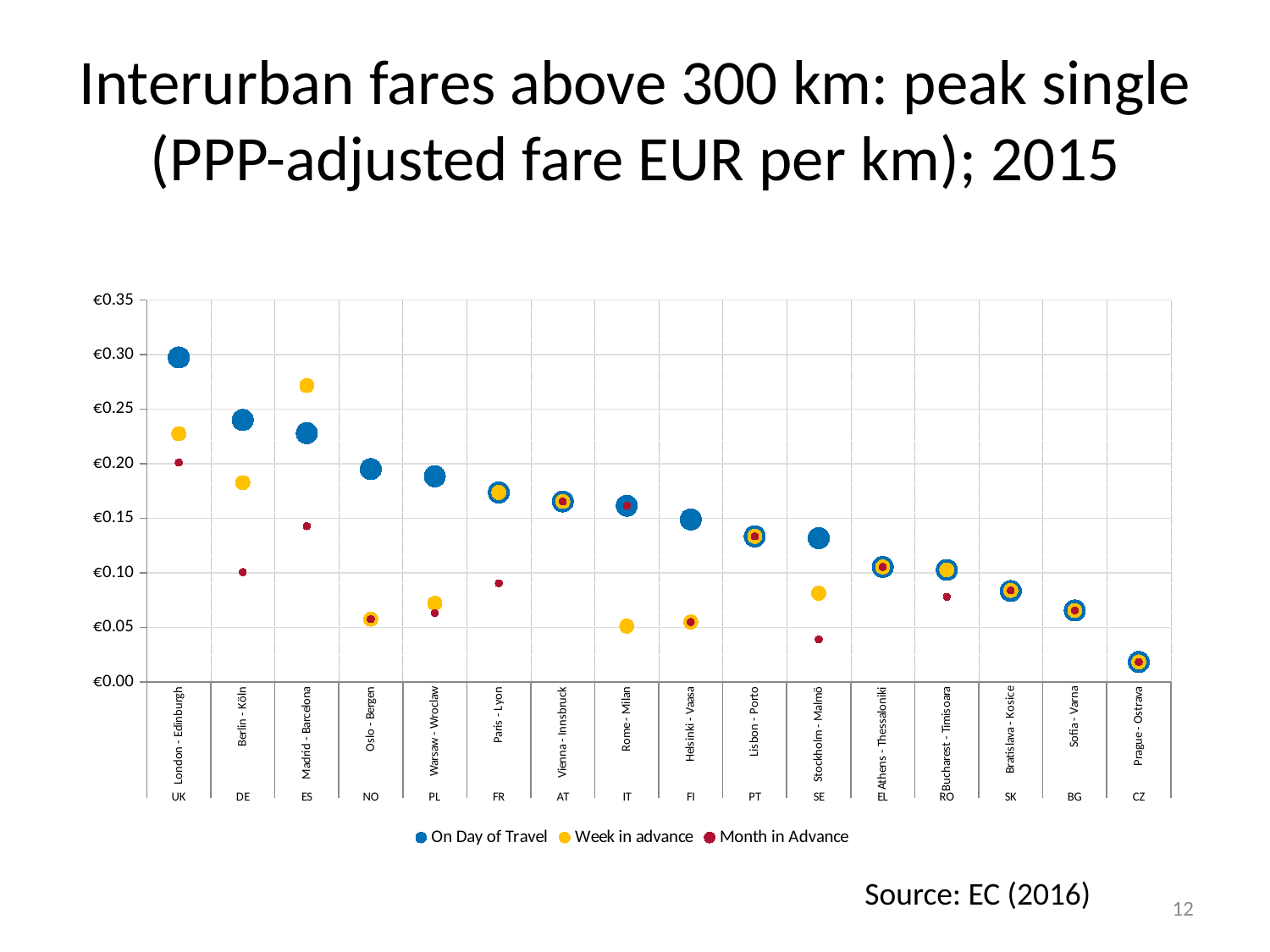
Is the On Day of Travel value for London - Edinburgh greater or less than €0.25? greater Do the On Day of Travel values generally rise or fall from left to right along the x axis? Fall Which route has the lowest On Day of Travel fare per km? Prague - Ostrava How many series does the legend list? 3 What kind of chart is shown on the slide? Scatter chart Which route has the highest On Day of Travel fare per km? London - Edinburgh Is the Month in Advance value for Paris - Lyon greater or less than €0.10? less How many routes are plotted along the x axis? 16 Is the Month in Advance value for Stockholm - Malmö greater or less than €0.05? less What source is cited for the chart? EC (2016) Which route has the highest Week in advance fare per km? Madrid - Barcelona For Madrid - Barcelona, which is larger: the Week in advance fare or the On Day of Travel fare? Week in advance